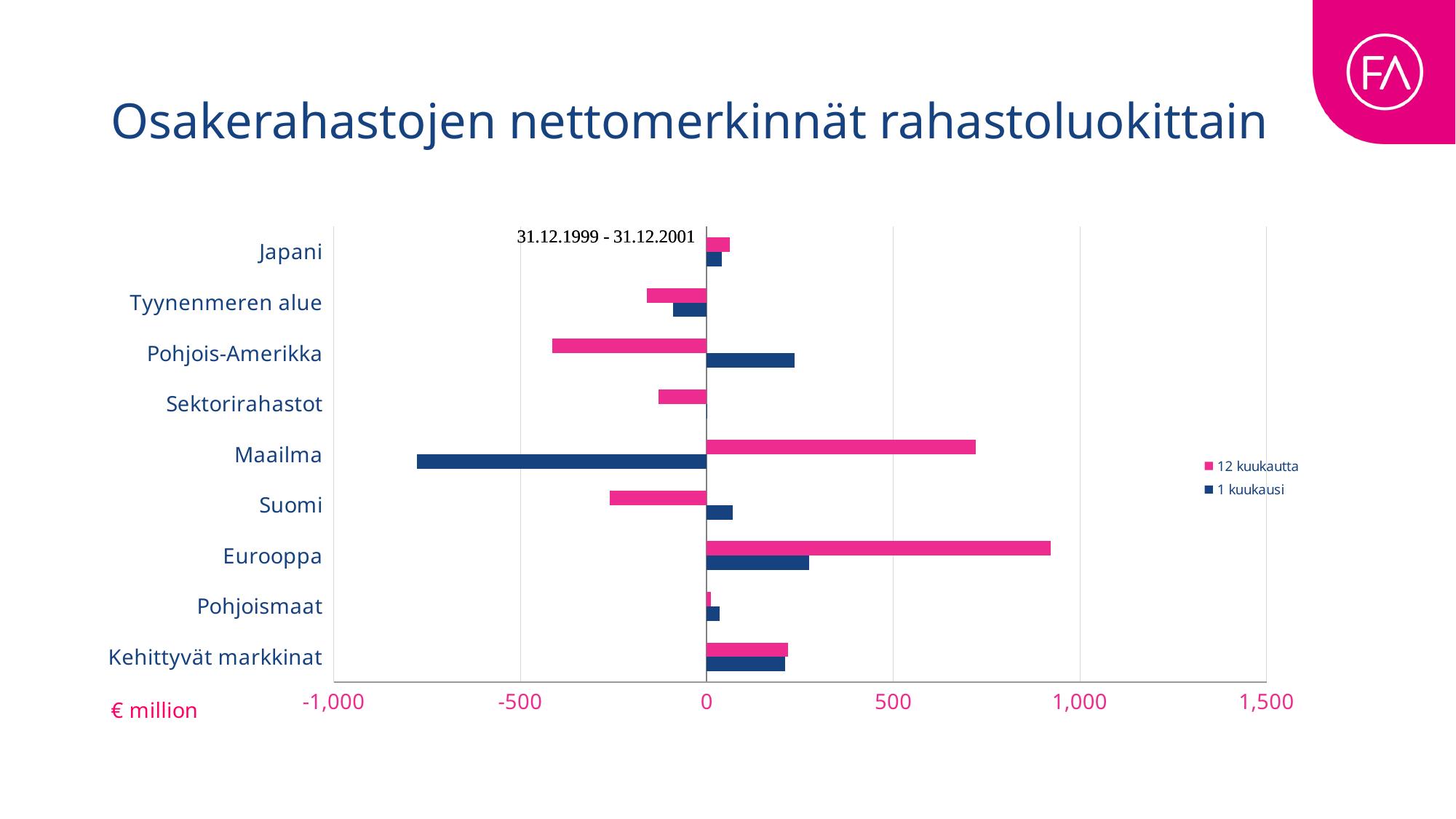
What kind of chart is shown on the slide? Bar chart What is the title of the chart on the slide? Osakerahastojen nettomerkinnät rahastoluokittain Is the 12 kuukautta value for Eurooppa greater or less than 500? greater Which category has the lowest value for the 12 kuukautta series? Pohjois-Amerikka How many fund categories are listed on the vertical axis of the chart? 9 Is the 1 kuukausi value for Maailma greater or less than -500? less Which category has the highest value for the 12 kuukautta series? Eurooppa How many series does the chart's legend list? 2 Which is larger for the 1 kuukausi series: Pohjois-Amerikka or Suomi? Pohjois-Amerikka What unit is shown for the horizontal axis of the chart? € million Is the 12 kuukautta value for Pohjois-Amerikka greater or less than -500? greater Which category has the lowest value for the 1 kuukausi series? Maailma